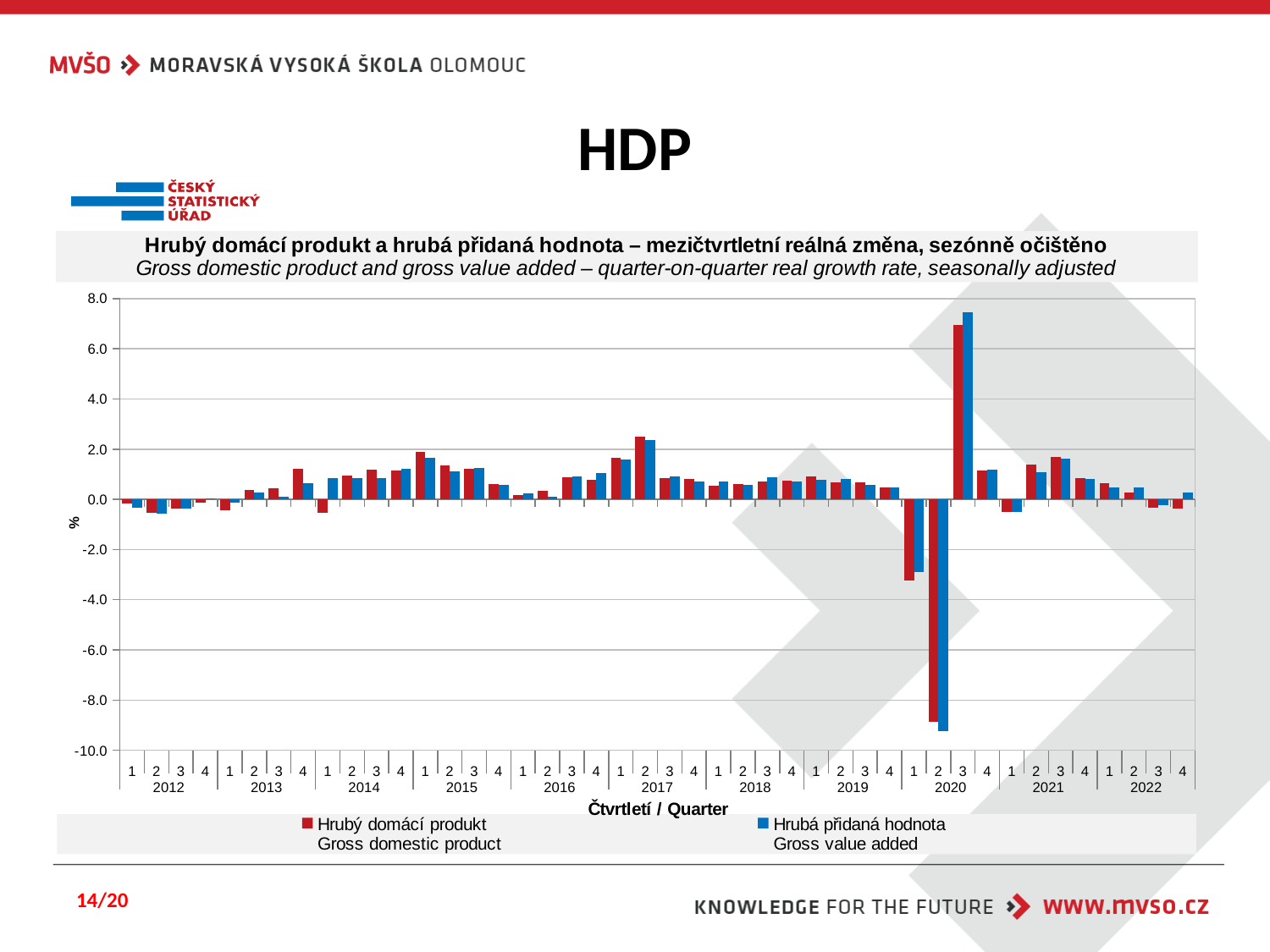
Which is larger, the Gross domestic product value for Q3 2020 or for Q4 2020? Q3 2020 Is the Gross domestic product value for Q1 2020 greater or less than -2.0? less Is the Gross domestic product value for Q3 2020 greater or less than 6.0? greater In which quarter is the Gross domestic product value highest? Q3 2020 What is the title of the x axis? Čtvrtletí / Quarter Is the Gross domestic product value for Q2 2017 greater or less than 2.0? greater How many series does the legend list? 2 In which quarter is the Gross value added value lowest? Q2 2020 What is the label of the y axis? % What kind of chart is shown on the slide? Bar chart How many years are shown along the x axis? 11